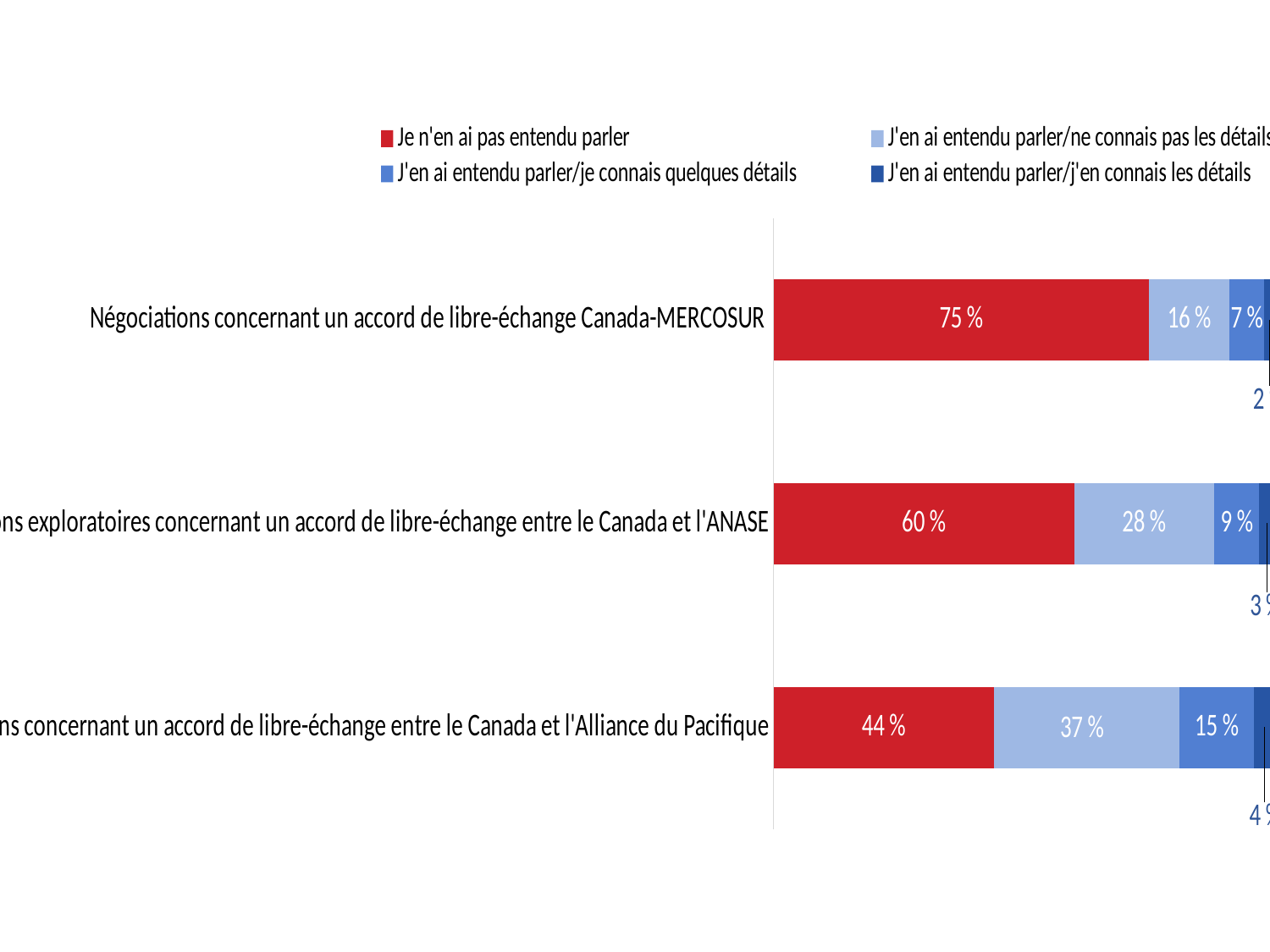
Which agreement has the lowest share of "Je n'en ai pas entendu parler"? The Canada–Alliance du Pacifique agreement How many series does the legend list? 4 Which has a larger "J'en ai entendu parler/ne connais pas les détails" share: the Canada–ANASE bar or the Canada-MERCOSUR bar? The Canada–ANASE bar What is the value of "J'en ai entendu parler/ne connais pas les détails" for the Canada–ANASE free-trade agreement bar? 28 % How many bars (agreements) are shown in the chart? 3 What is the value of "J'en ai entendu parler/je connais quelques détails" for the Canada–Alliance du Pacifique free-trade agreement bar? 15 % What is the difference in the "Je n'en ai pas entendu parler" share between the Canada-MERCOSUR bar and the Canada–Alliance du Pacifique bar? 31 percentage points What colour represents "Je n'en ai pas entendu parler" in the chart? Red What percentage of respondents answered "Je n'en ai pas entendu parler" for the Canada-MERCOSUR free-trade negotiations? 75 % Which agreement has the highest share of "J'en ai entendu parler/ne connais pas les détails"? The Canada–Alliance du Pacifique agreement What kind of chart is shown on the slide? Stacked bar chart Which agreement has the highest share of "Je n'en ai pas entendu parler"? Négociations concernant un accord de libre-échange Canada-MERCOSUR